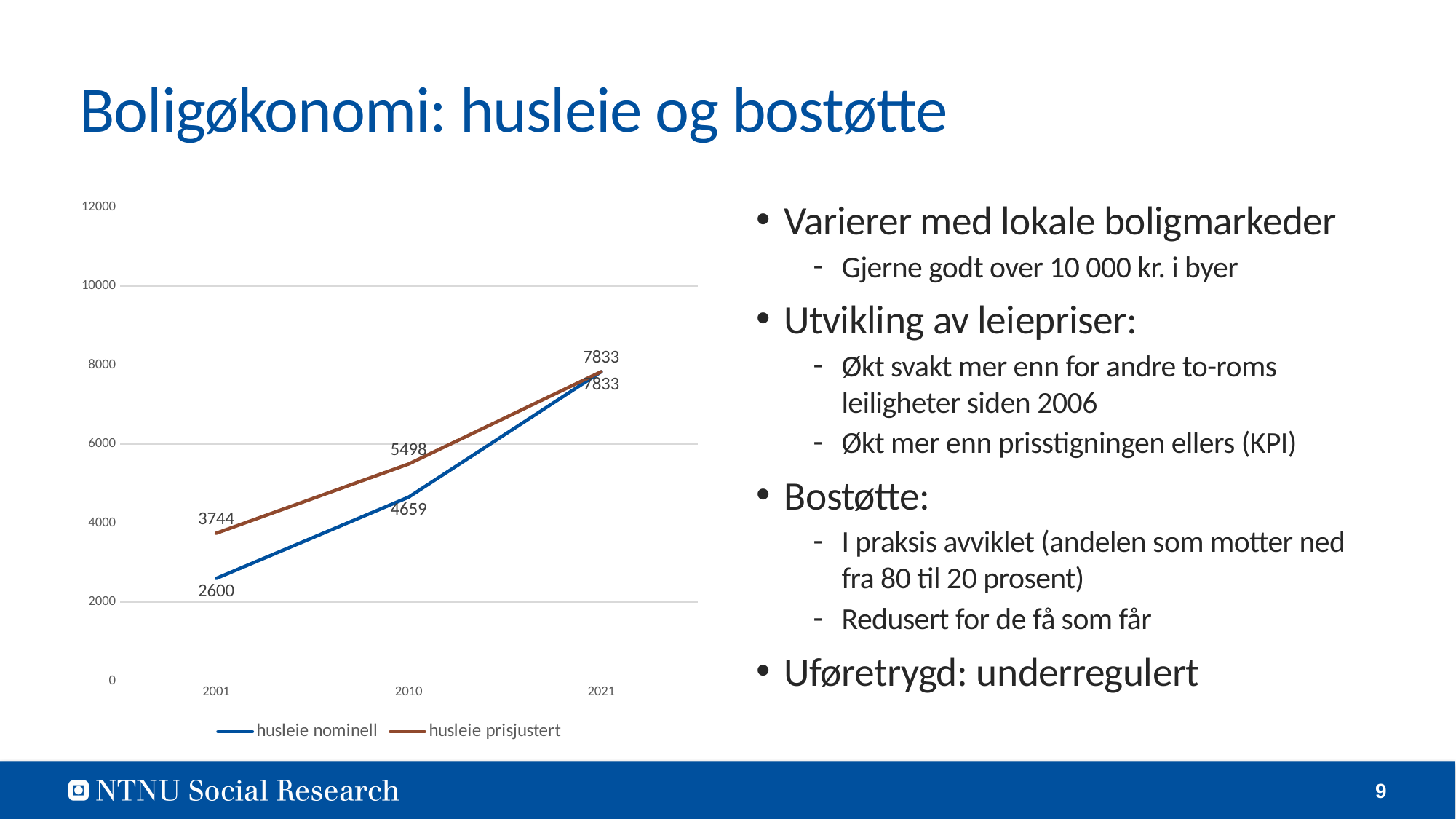
Does husleie nominell rise or fall from 2001 to 2021? rise What is the value of husleie nominell in 2021? 7833 Which is larger in 2001, husleie nominell or husleie prisjustert? husleie prisjustert What kind of chart is shown on the slide? line chart What is the value of husleie nominell in 2001? 2600 What is the value of husleie prisjustert in 2010? 5498 What is the value of husleie prisjustert in 2001? 3744 In which year is husleie nominell lowest? 2001 How many years are plotted on the x axis of the chart? 3 How many series does the chart legend list? 2 What is the difference between husleie prisjustert and husleie nominell in 2010? 839 Which series is drawn in blue in the chart? husleie nominell